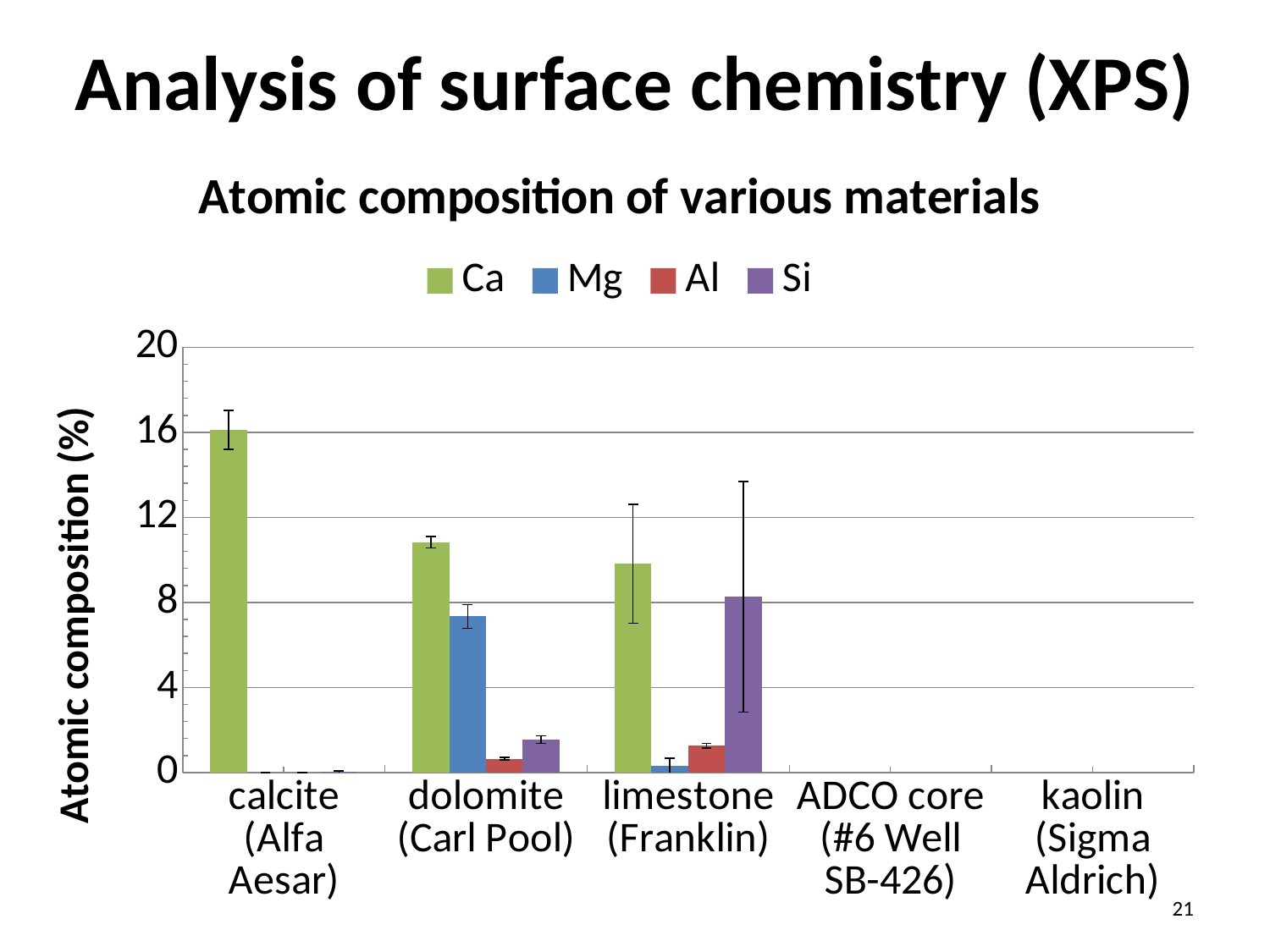
What is the label of the y axis? Atomic composition (%) Is the Ca value for limestone (Franklin) greater or less than 12? less How many materials (categories) are shown on the x axis? 5 What kind of chart is shown on the slide? bar chart Is the Ca value for calcite (Alfa Aesar) greater or less than 12? greater Is the Si value for limestone (Franklin) greater or less than 4? greater What is the title of the chart? Atomic composition of various materials Which element has the highest value for dolomite (Carl Pool)? Ca Which material has the highest Ca value? calcite (Alfa Aesar) How many series does the legend list? 4 Which is larger, the Mg value for dolomite (Carl Pool) or the Mg value for limestone (Franklin)? dolomite (Carl Pool)